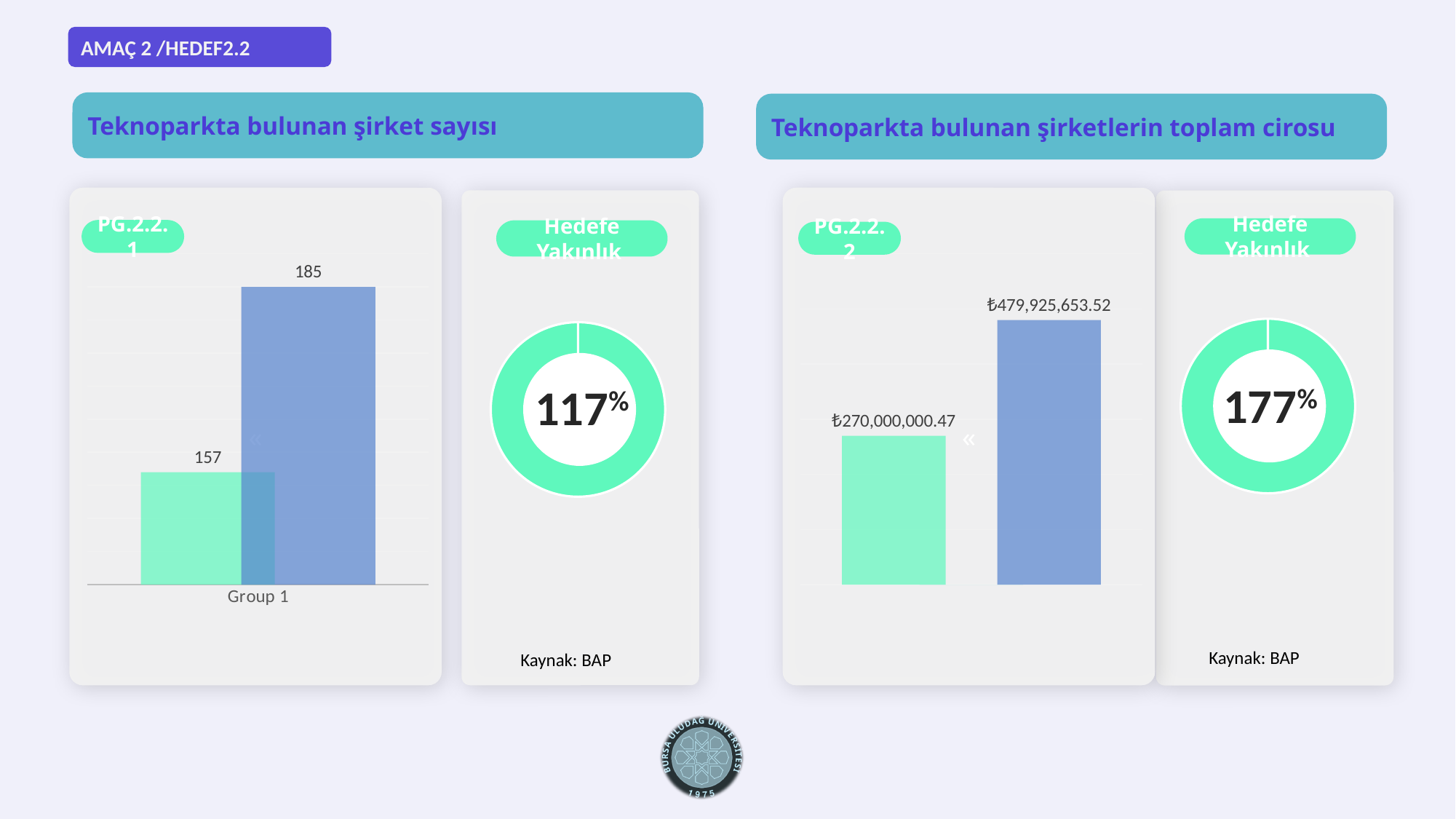
In the 'Teknoparkta bulunan şirket sayısı' bar chart, what is the value of the blue bar? 185 In the 'Teknoparkta bulunan şirketlerin toplam cirosu' bar chart, what is the value of the blue bar? ₺479,925,653.52 In the 'Teknoparkta bulunan şirketlerin toplam cirosu' bar chart, what is the value of the green bar? ₺270,000,000.47 In the 'Teknoparkta bulunan şirketlerin toplam cirosu' bar chart, which bar has the lower value? the green bar What percentage is shown in the 'Hedefe Yakınlık' donut chart next to the 'Teknoparkta bulunan şirketlerin toplam cirosu' chart? 177% What is the category label on the x axis of the 'Teknoparkta bulunan şirket sayısı' bar chart? Group 1 What type of chart is used under the 'Teknoparkta bulunan şirket sayısı' heading? bar chart In the 'Teknoparkta bulunan şirket sayısı' bar chart, which bar is taller, the green one or the blue one? the blue one How many bars are plotted in the 'Teknoparkta bulunan şirketlerin toplam cirosu' bar chart? 2 What percentage is shown in the 'Hedefe Yakınlık' donut chart next to the 'Teknoparkta bulunan şirket sayısı' chart? 117% In the 'Teknoparkta bulunan şirket sayısı' bar chart, what is the value of the green bar? 157 In the 'Teknoparkta bulunan şirket sayısı' bar chart, what is the difference between the blue bar and the green bar? 28